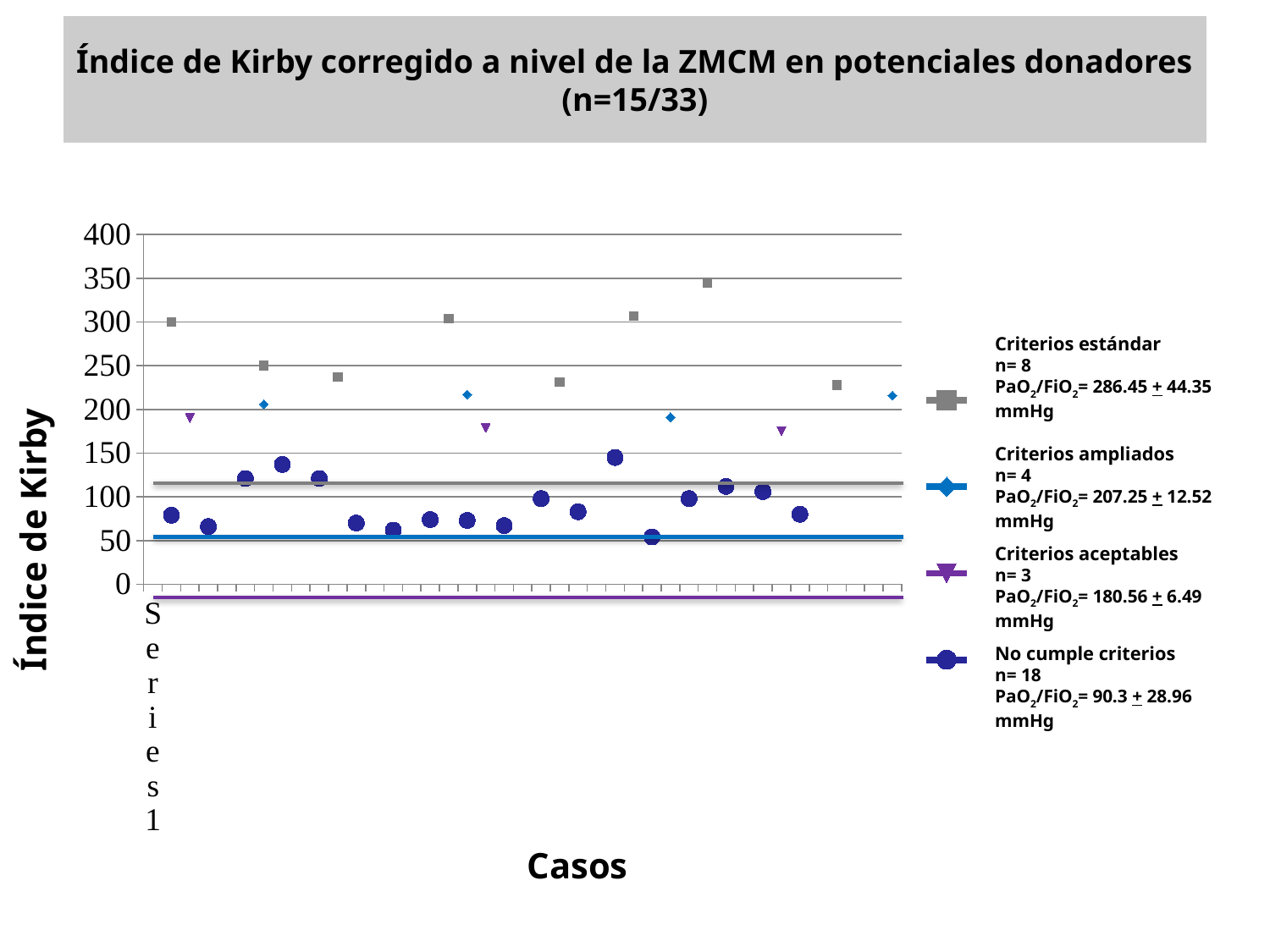
What is the label of the vertical axis? Índice de Kirby How many series does the chart legend list? 4 Are all the 'Criterios aceptables' points greater or less than 200? less What is the title of the chart? Índice de Kirby corregido a nivel de la ZMCM en potenciales donadores (n=15/33) Which series has the lowest mean PaO2/FiO2 value in the legend? No cumple criterios According to the legend, what is the PaO2/FiO2 value for 'Criterios aceptables'? 180.56 ± 6.49 mmHg According to the legend, how many cases are in the 'No cumple criterios' series? 18 What kind of chart is shown on the slide? scatter chart According to the legend, how many cases are in the 'Criterios estándar' series? 8 According to the legend, what is the PaO2/FiO2 value for 'Criterios ampliados'? 207.25 ± 12.52 mmHg Is the highest 'Criterios estándar' point greater or less than 300? greater Which series has the highest mean PaO2/FiO2 value in the legend? Criterios estándar